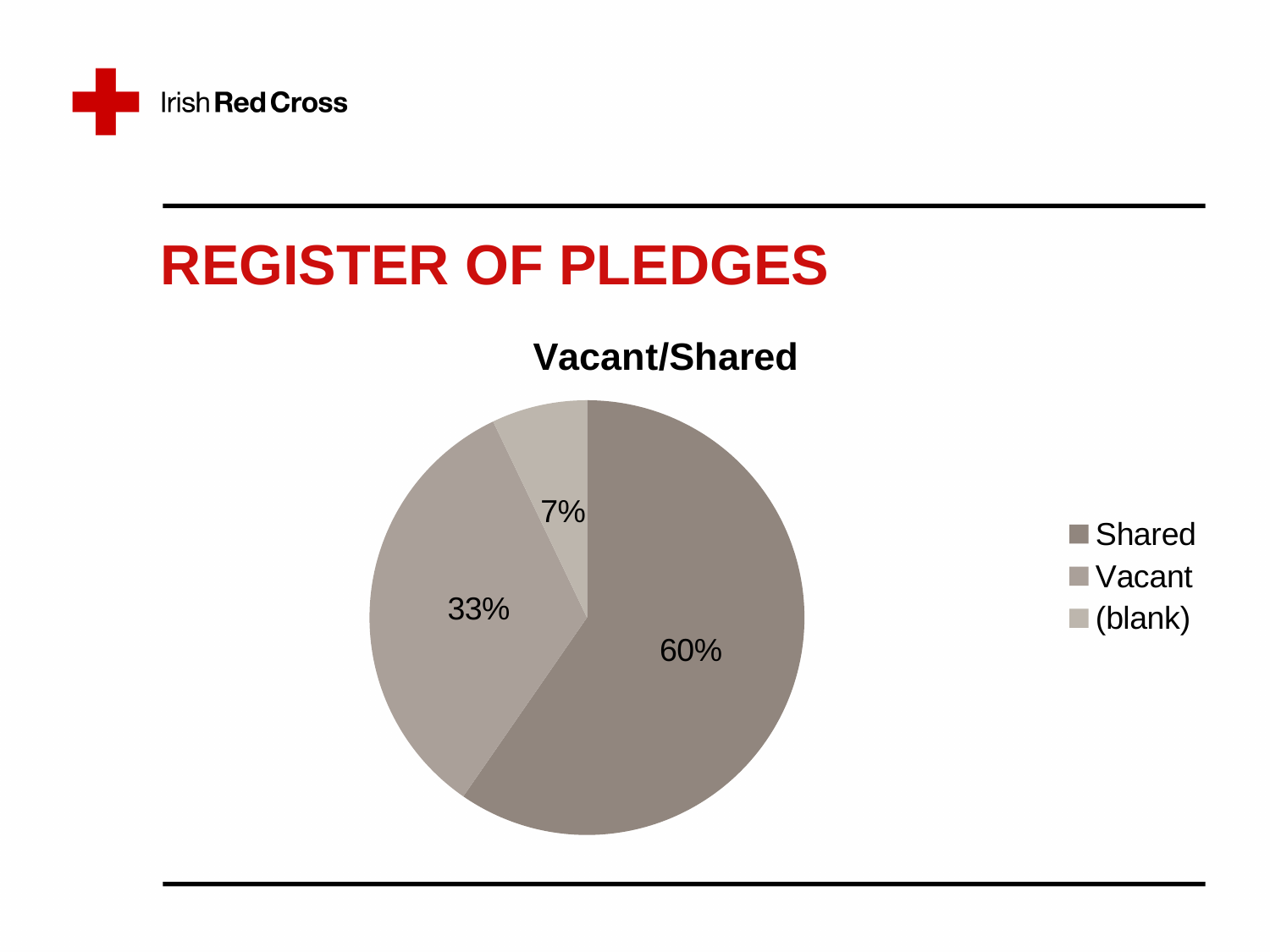
What is the combined share of the Vacant and (blank) slices? 40% How many slices does the pie chart have? 3 Which category has the smallest slice of the pie? (blank) What is the title of the chart? Vacant/Shared What share of the pie is (blank)? 7% What kind of chart is shown on the slide? pie chart What share of the pie is Shared? 60% What share of the pie is Vacant? 33% Which category has the largest slice of the pie? Shared Which is larger, the Vacant slice or the (blank) slice? Vacant How many entries does the legend list? 3 What is the difference in percentage points between the Shared and Vacant slices? 27